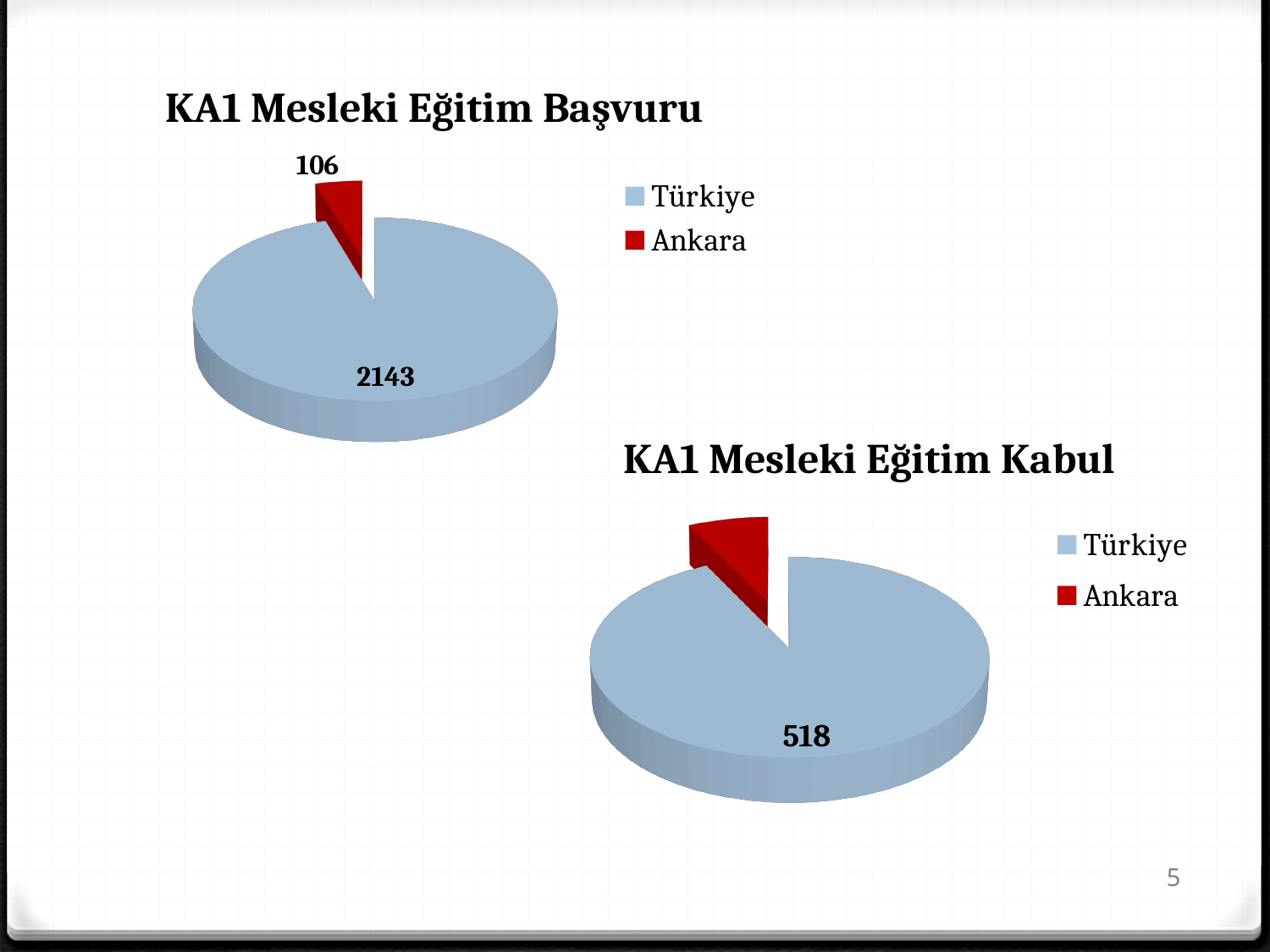
In the 'KA1 Mesleki Eğitim Başvuru' chart, which category has the largest slice? Türkiye In the 'KA1 Mesleki Eğitim Başvuru' chart, what is the value for Ankara? 106 In the 'KA1 Mesleki Eğitim Kabul' chart, what colour is the Ankara slice? Red How many categories does the 'KA1 Mesleki Eğitim Kabul' chart show? 2 In the 'KA1 Mesleki Eğitim Başvuru' chart, what is the value for Türkiye? 2143 In the 'KA1 Mesleki Eğitim Kabul' chart, which is larger, Türkiye or Ankara? Türkiye What is the title of the chart in the lower right of the slide? KA1 Mesleki Eğitim Kabul In the 'KA1 Mesleki Eğitim Kabul' chart, what is the value for Türkiye? 518 In the 'KA1 Mesleki Eğitim Başvuru' chart, what is the difference between the Türkiye and Ankara values? 2037 What type of chart is 'KA1 Mesleki Eğitim Başvuru'? Pie chart In the 'KA1 Mesleki Eğitim Kabul' chart, which category has the smallest slice? Ankara How many entries does the legend of the 'KA1 Mesleki Eğitim Başvuru' chart list? 2